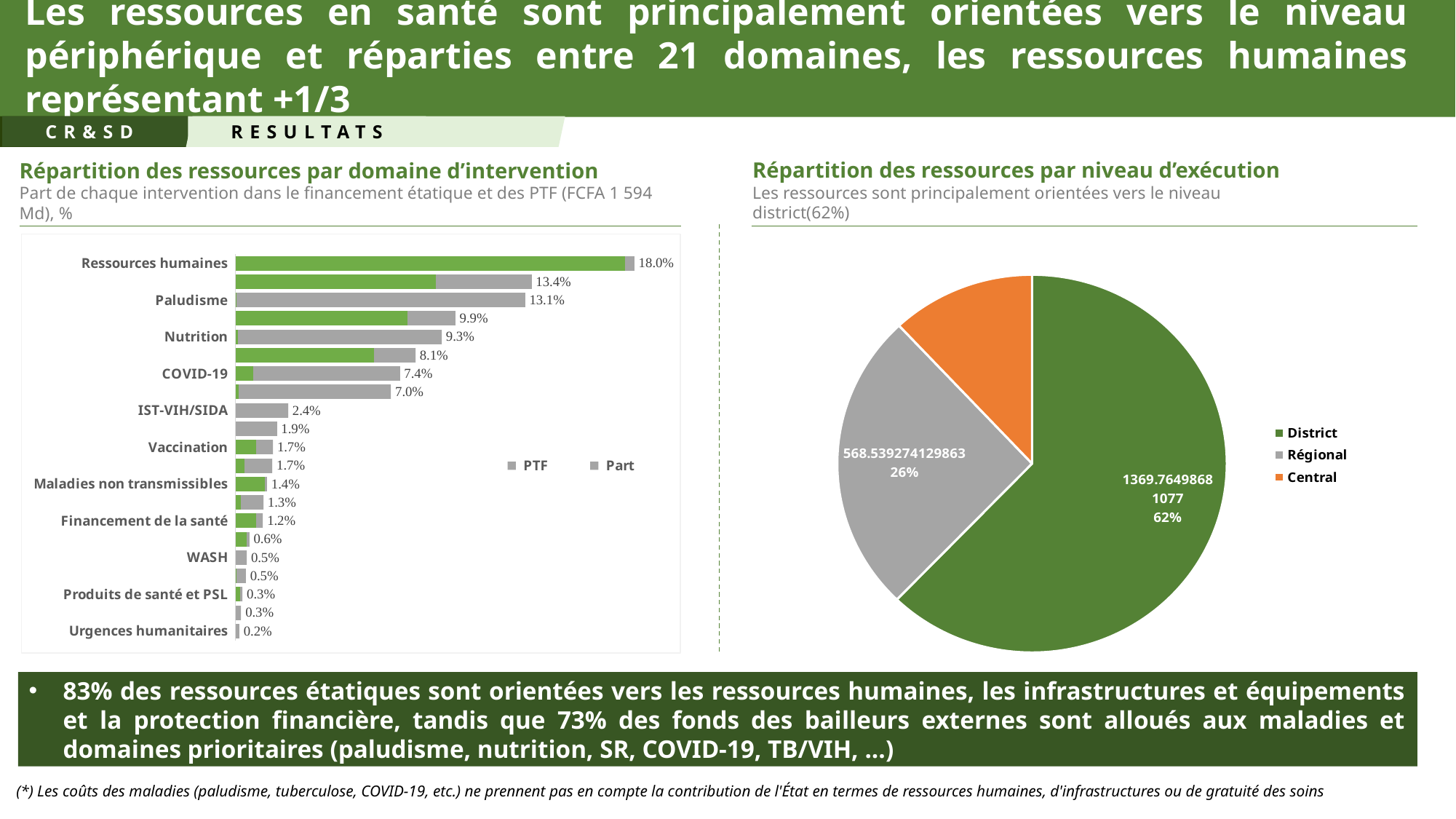
What kind of chart is 'Répartition des ressources par niveau d'exécution'? Pie chart In the chart 'Répartition des ressources par domaine d'intervention', what is the value for Paludisme? 13.1% How many bars are plotted in the chart 'Répartition des ressources par domaine d'intervention'? 21 In the chart 'Répartition des ressources par domaine d'intervention', what is the value for WASH? 0.5% How many entries does the legend of the chart 'Répartition des ressources par niveau d'exécution' list? 3 In the chart 'Répartition des ressources par domaine d'intervention', which domain has the highest value? Ressources humaines In the chart 'Répartition des ressources par niveau d'exécution', what share does District represent? 62% In the chart 'Répartition des ressources par domaine d'intervention', what is the difference between Ressources humaines and Paludisme? 4.9% What kind of chart is 'Répartition des ressources par domaine d'intervention'? Bar chart In the chart 'Répartition des ressources par domaine d'intervention', what is the value for Ressources humaines? 18.0% In the chart 'Répartition des ressources par domaine d'intervention', which labelled domain has the lowest value? Urgences humanitaires In the chart 'Répartition des ressources par domaine d'intervention', which is larger: Nutrition or COVID-19? Nutrition